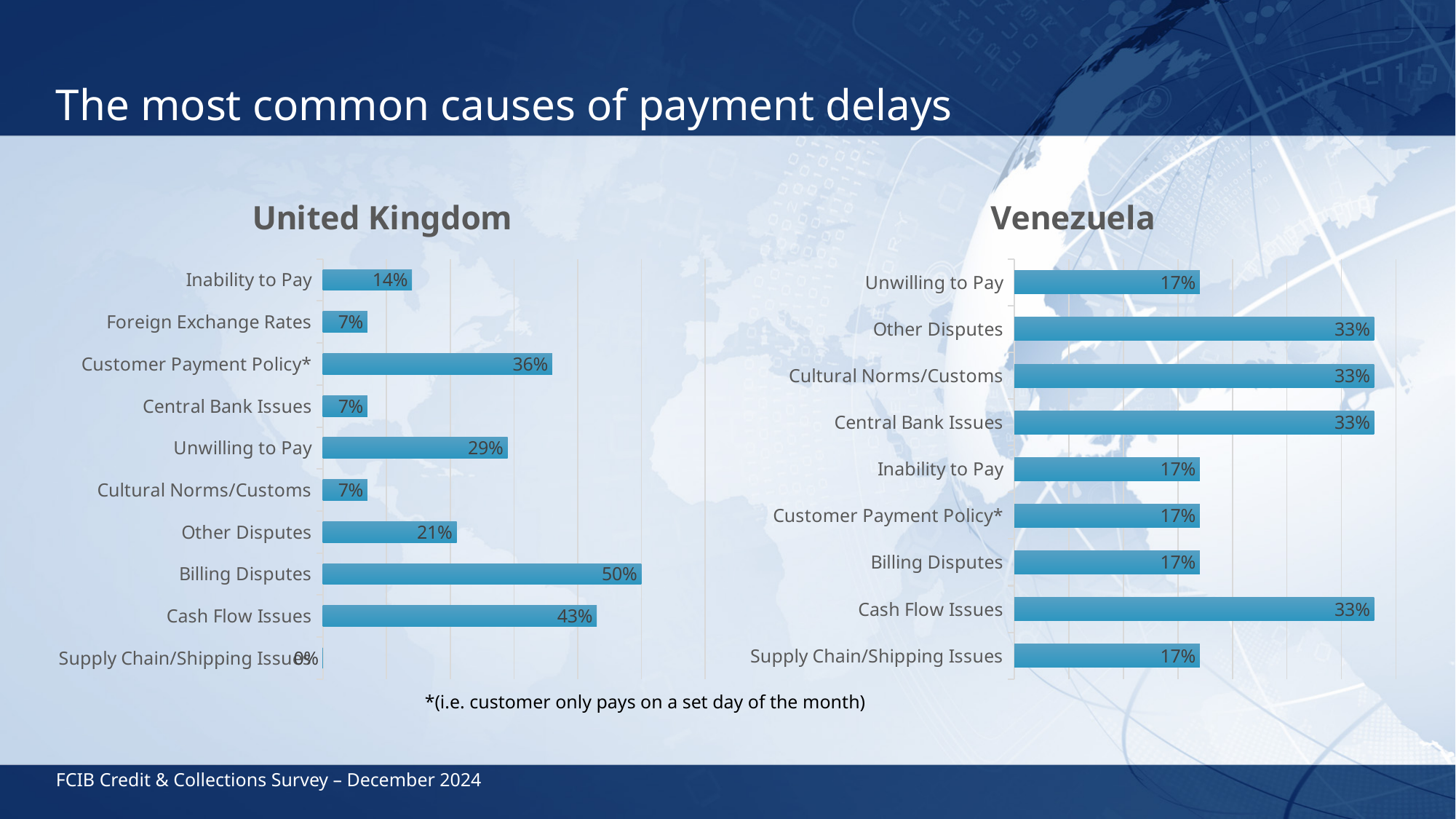
In the Venezuela chart, what is the difference between Other Disputes and Billing Disputes? 16% In the United Kingdom chart, which category has the lowest value? Supply Chain/Shipping Issues How many categories are shown in the Venezuela chart? 9 In the United Kingdom chart, what is the value for Customer Payment Policy*? 36% What type of chart is the Venezuela chart? Bar chart In the United Kingdom chart, what is the difference between Billing Disputes and Cash Flow Issues? 7% In the United Kingdom chart, what is the value for Billing Disputes? 50% In the Venezuela chart, what is the value for Unwilling to Pay? 17% How many categories are shown in the United Kingdom chart? 10 In the United Kingdom chart, which category has the highest value? Billing Disputes In the United Kingdom chart, which is larger: Unwilling to Pay or Other Disputes? Unwilling to Pay In the Venezuela chart, what is the value for Cash Flow Issues? 33%